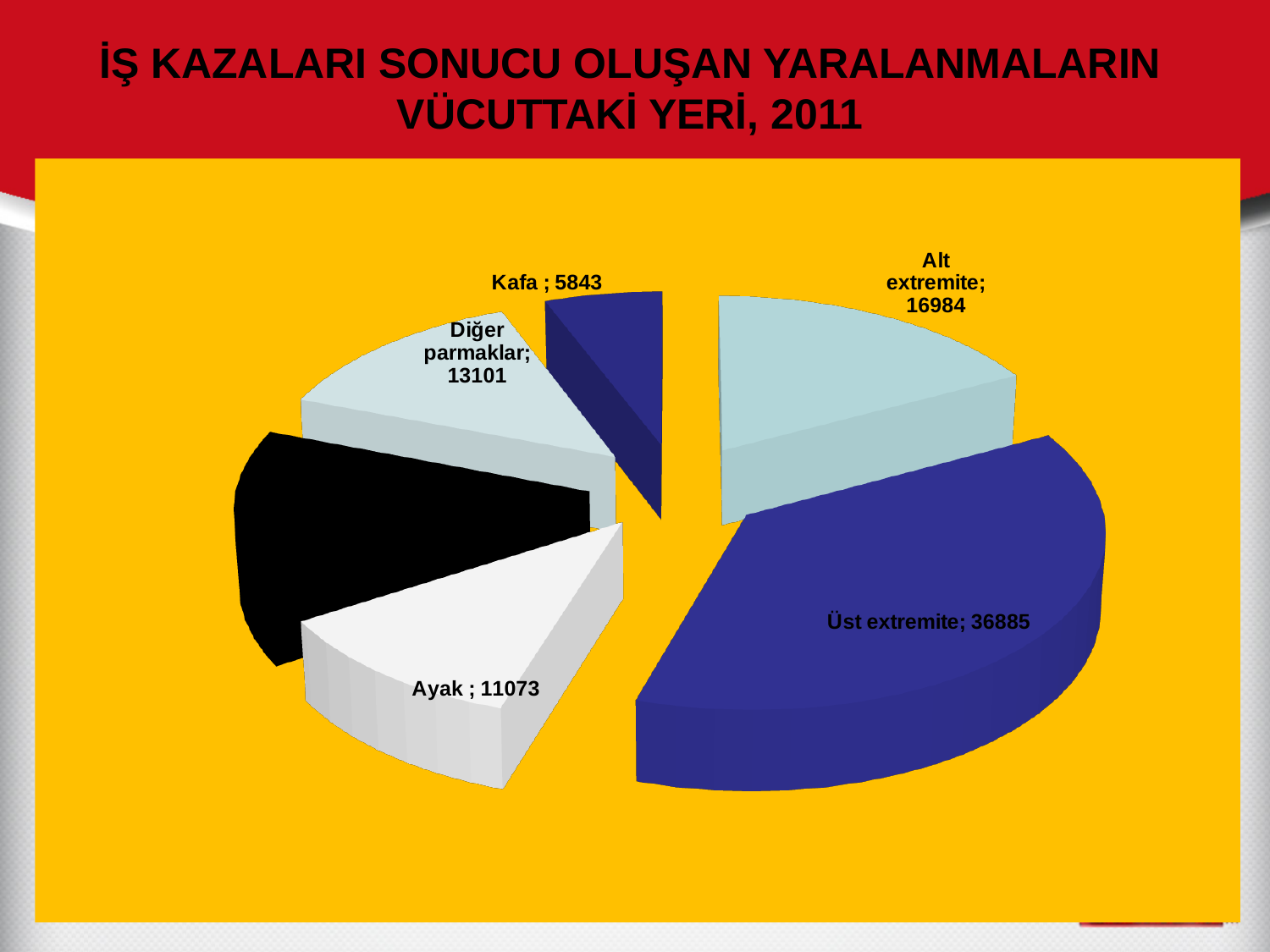
What is the difference between the values for Ayak and Kafa? 5230 What is the value for Ayak? 11073 Which is larger, the value for Alt extremite or the value for Diğer parmaklar? Alt extremite Which labeled category has the smallest slice of the pie? Kafa What is the value for Diğer parmaklar? 13101 What is the value for Kafa? 5843 Which year does the chart title refer to? 2011 Which category has the largest slice of the pie? Üst extremite What kind of chart is shown on the slide? pie chart What is the value for Alt extremite? 16984 What is the value for Üst extremite? 36885 What is the difference between the values for Üst extremite and Alt extremite? 19901